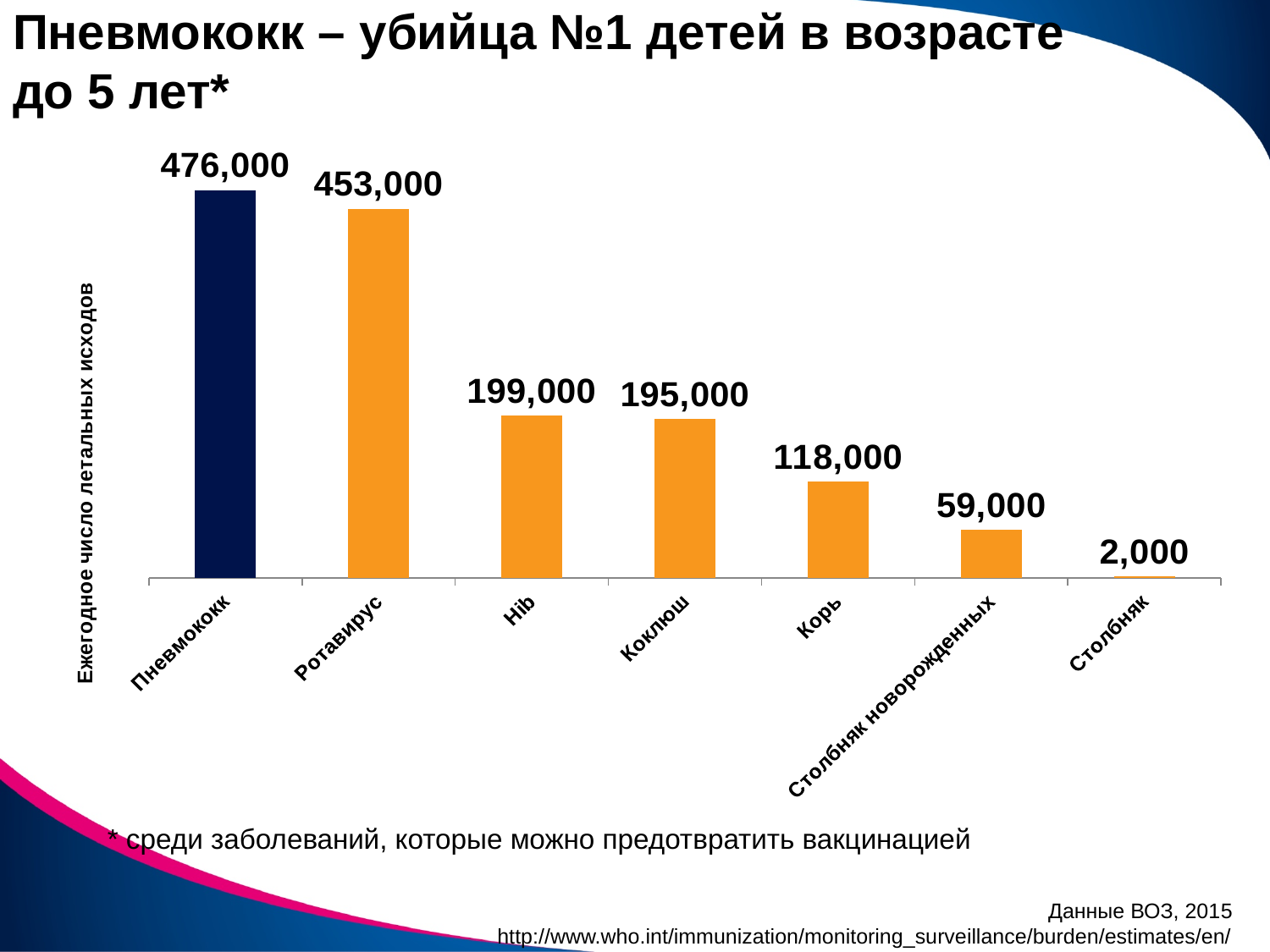
What is the annual number of deaths shown for Пневмококк? 476,000 What type of chart is shown on the slide? Bar chart What value is shown for Ротавирус? 453,000 What value is shown for Hib? 199,000 What value is shown for Корь? 118,000 Which is larger, the value for Корь or the value for Столбняк новорожденных? Корь Which category has the highest value? Пневмококк What value is shown for Столбняк новорожденных? 59,000 Which category has the lowest value? Столбняк How many categories are shown on the x axis? 7 What is the difference between the values for Hib and Коклюш? 4,000 What is the difference between the values for Пневмококк and Ротавирус? 23,000